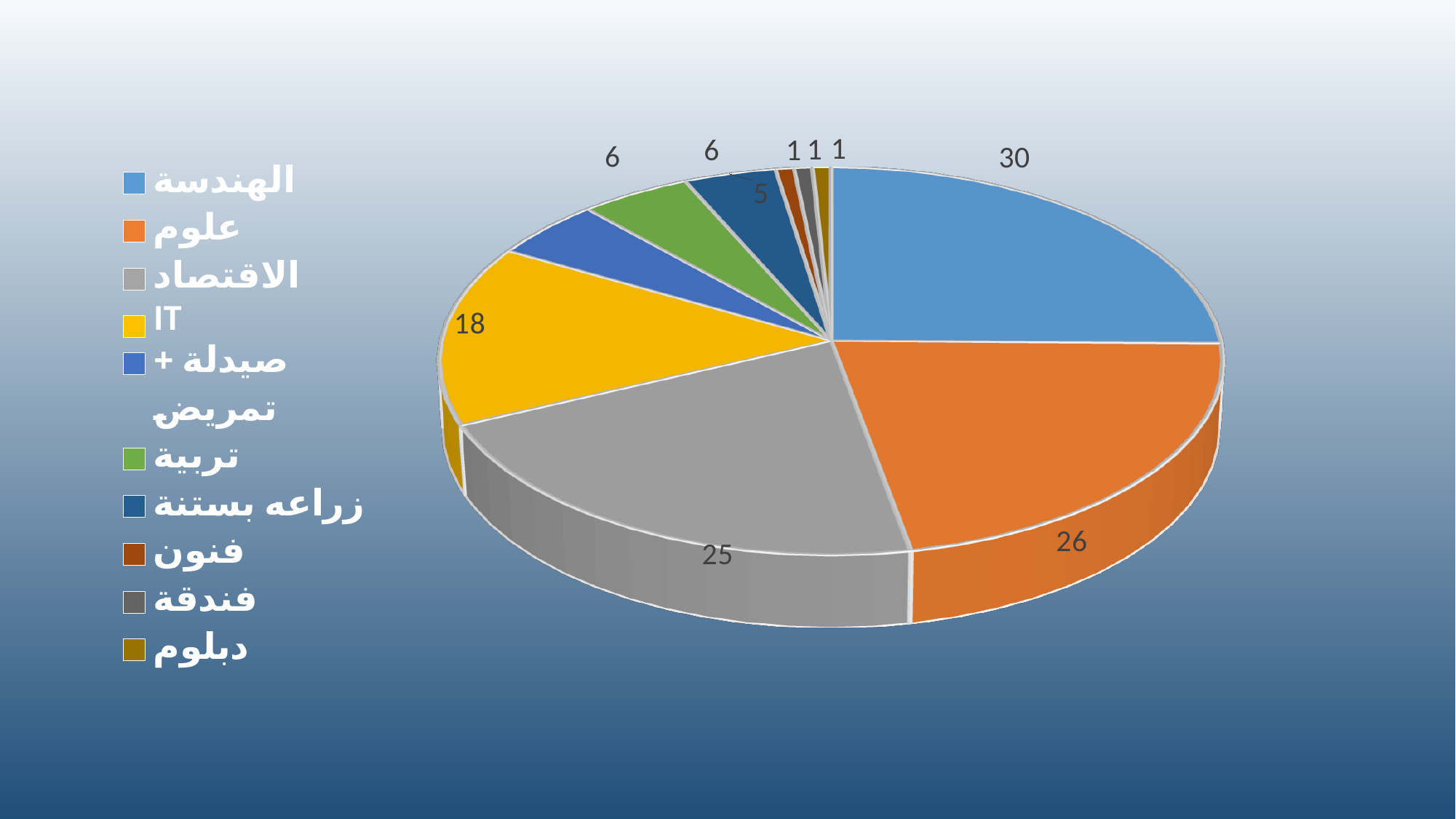
What is the value for IT? 18 What kind of chart is shown on the slide? pie chart What is the value for زراعه بستنة? 5 What is the value for الاقتصاد? 25 What is the value for الهندسة? 30 Which is larger, the value for الاقتصاد or the value for IT? الاقتصاد What is the difference between the values for الهندسة and علوم? 4 What is the value for علوم? 26 What colour is the slice for الهندسة? blue Which category has the largest slice? الهندسة How many categories does the legend list? 10 Which categories share the smallest value in the chart? فنون, فندقة, دبلوم